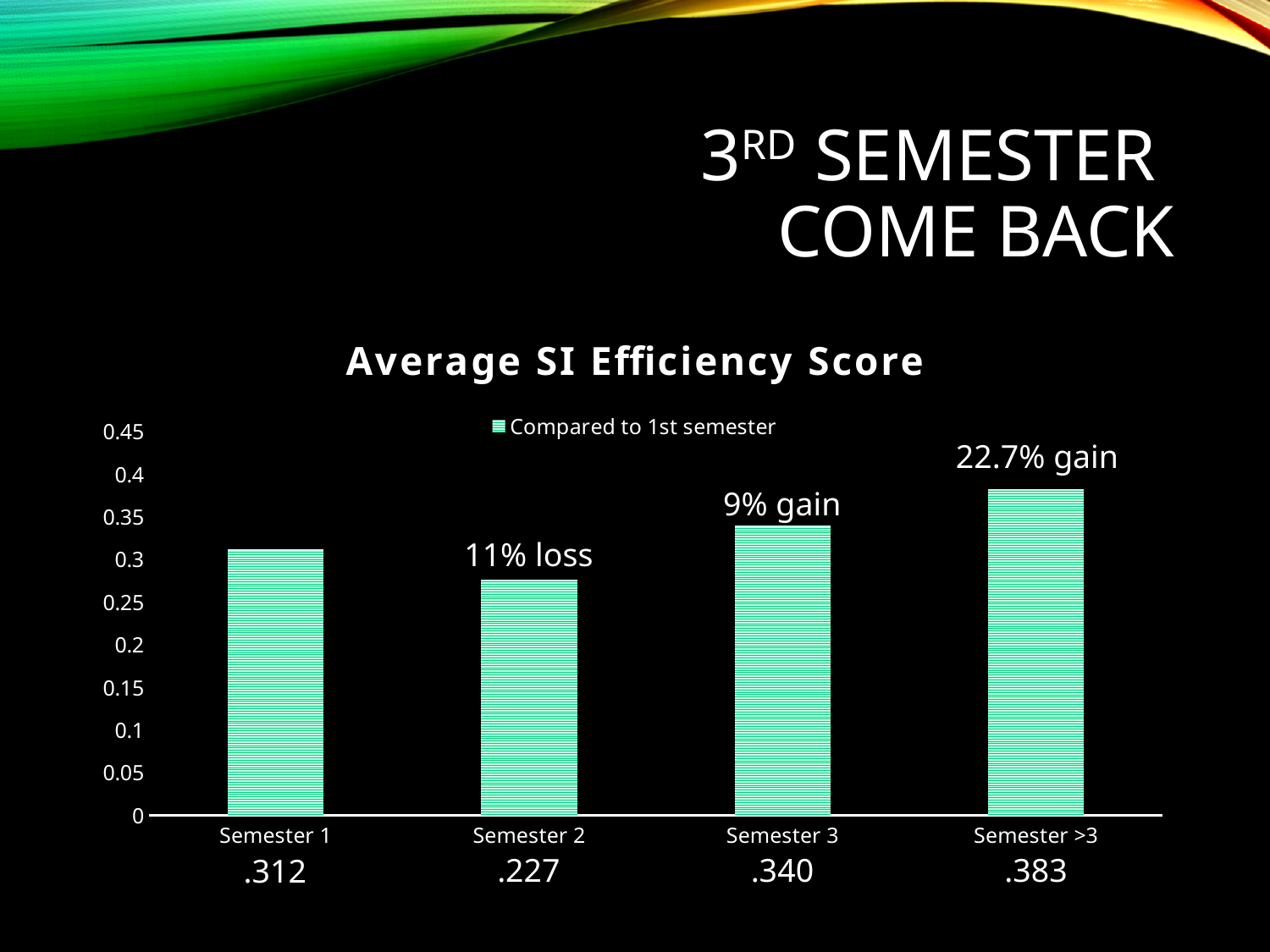
How many semester categories are shown on the x axis? 4 What is the difference between the values for Semester >3 and Semester 1? .071 Which semester has the highest Average SI Efficiency Score? Semester >3 What is the value for Semester 1? .312 Which semester has the lowest Average SI Efficiency Score? Semester 2 What kind of chart is shown on the slide? bar chart What is the value for Semester >3? .383 What is the title of the chart? Average SI Efficiency Score What is the value for Semester 3? .340 How many series does the legend list? 1 Which is larger, the value for Semester 3 or the value for Semester 1? Semester 3 Is the value for Semester 2 greater or less than 0.3? less